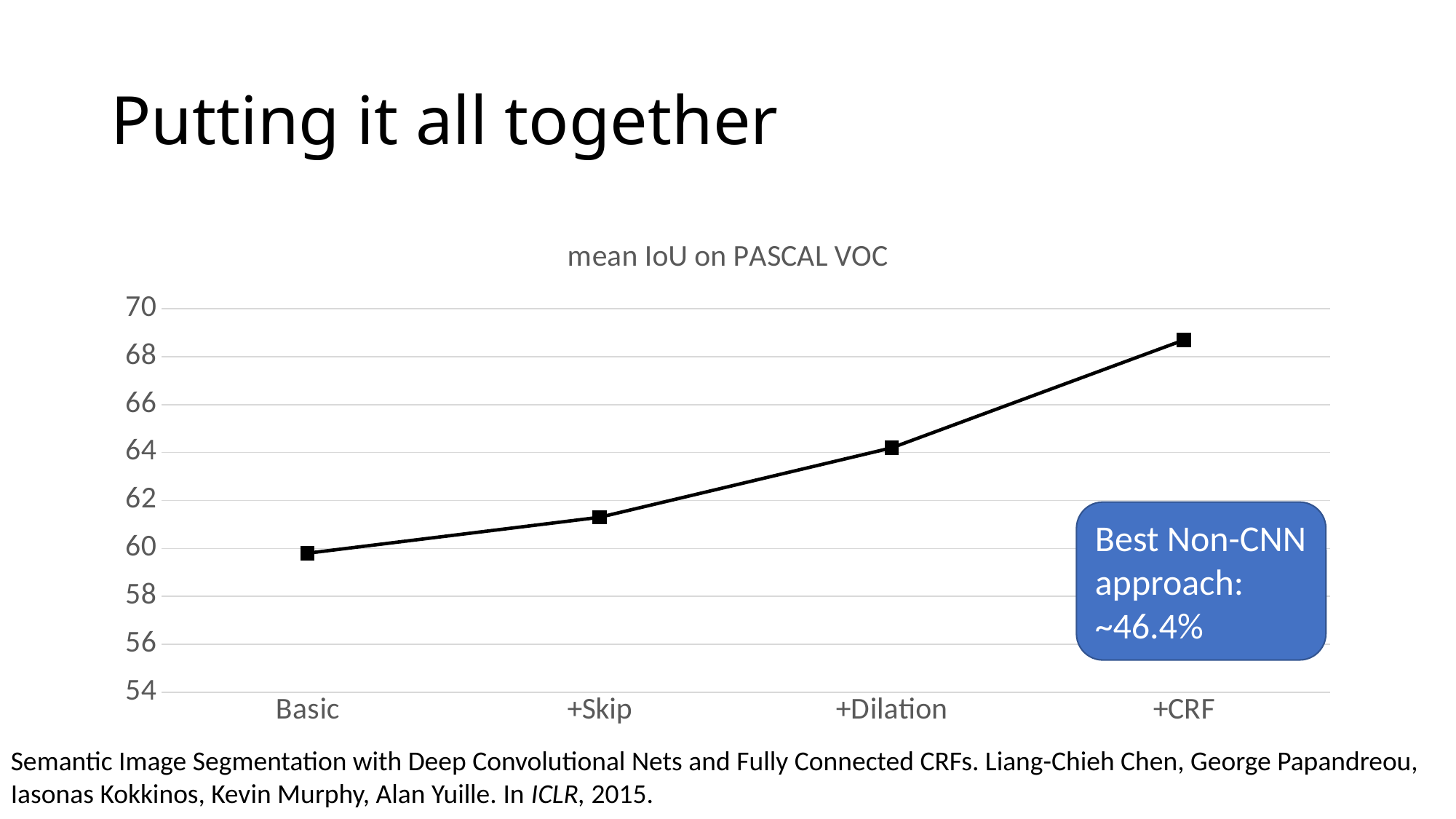
What is the title of the chart? mean IoU on PASCAL VOC Which has a lower mean IoU, Basic or +CRF? Basic Is the value for +Skip greater or less than 60? greater How many categories are plotted along the x axis? 4 Is the value for +Dilation greater or less than 62? greater What kind of chart is shown on the slide? line chart Which category has the highest mean IoU? +CRF Which has a higher mean IoU, +Skip or +Dilation? +Dilation Is the value for +CRF greater or less than 66? greater Which category has the lowest mean IoU? Basic Do the values rise or fall from Basic to +CRF along the x axis? rise